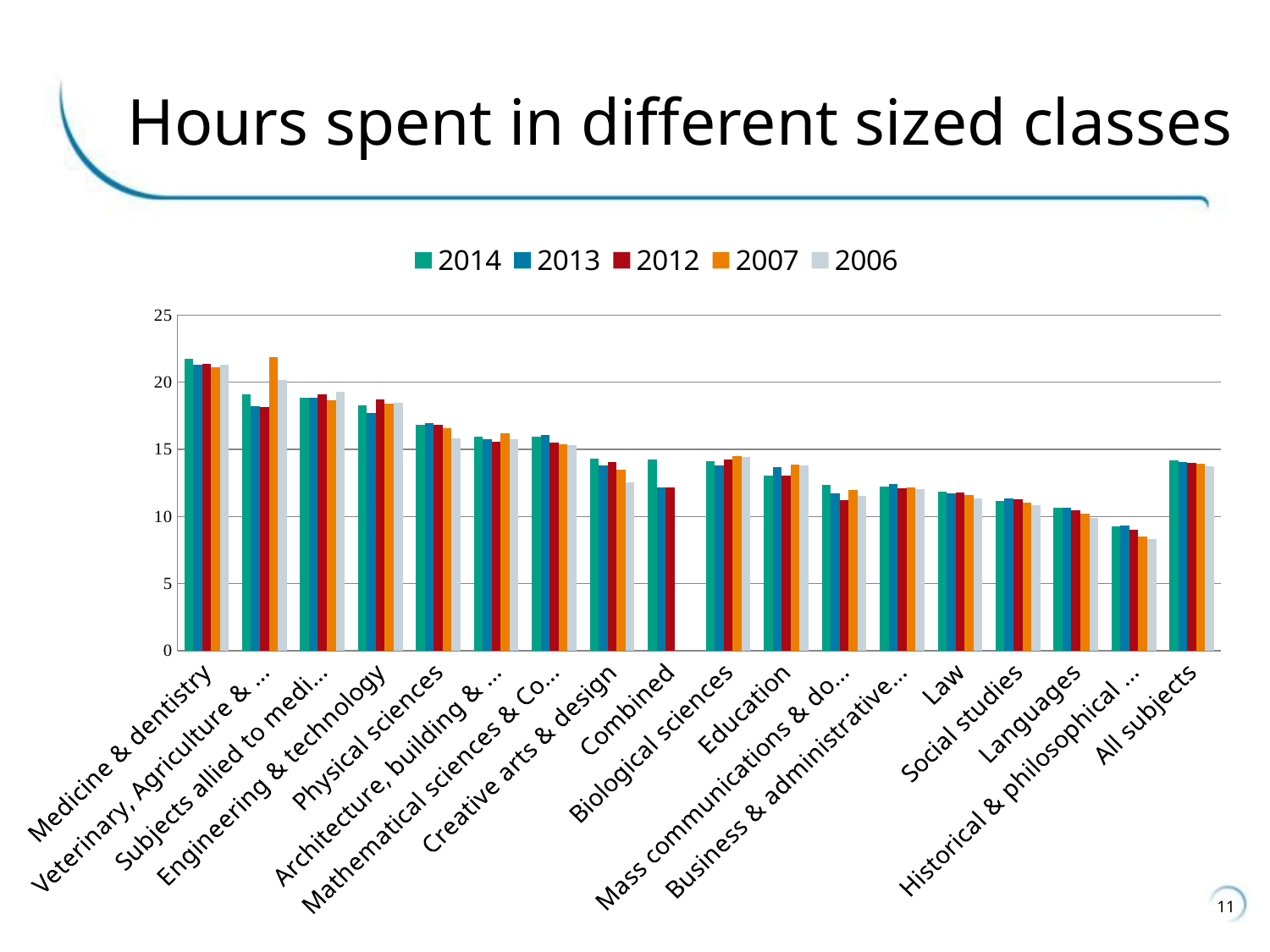
What kind of chart is shown on the slide? bar chart Is the 2014 value for Historical & philosophical ... greater or less than 10? less Which subject has the highest 2014 value? Medicine & dentistry How many series does the legend list? 5 Is the 2014 value for Medicine & dentistry greater or less than 20? greater Is the 2014 value for Law greater or less than 15? less For Veterinary, Agriculture & ..., which is larger: the 2007 value or the 2014 value? 2007 Which subject has the lowest 2014 value? Historical & philosophical ... What is the title of the chart? Hours spent in different sized classes Which is larger: the 2014 value for Medicine & dentistry or the 2014 value for Law? Medicine & dentistry How many subject categories are shown along the x axis? 18